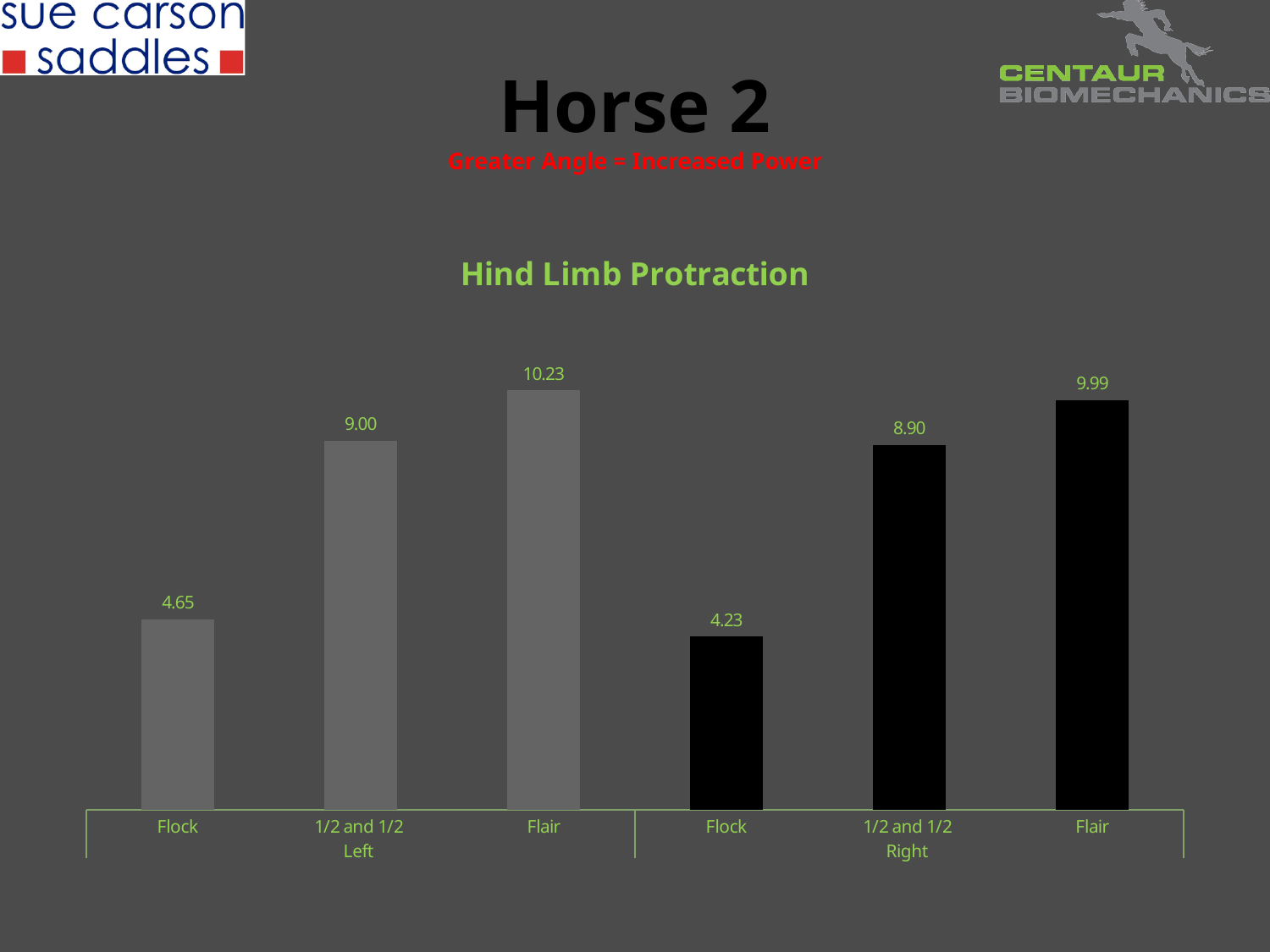
What is the value for Flock on the Right side? 4.23 Which bar has the highest value in the chart? Flair (Left) What is the Hind Limb Protraction value for Flock on the Left side? 4.65 Which is larger: 1/2 and 1/2 on the Left or 1/2 and 1/2 on the Right? 1/2 and 1/2 on the Left What is the difference between the Flair and Flock values on the Left side? 5.58 Which bar has the lowest value in the chart? Flock (Right) What is the difference between the Flair values for Left and Right? 0.24 What is the title of the chart? Hind Limb Protraction What is the Hind Limb Protraction value for Flair on the Right side? 9.99 What is the value for 1/2 and 1/2 on the Left side? 9.00 What type of chart is shown on the slide? Bar chart How many bars are plotted in the chart? 6